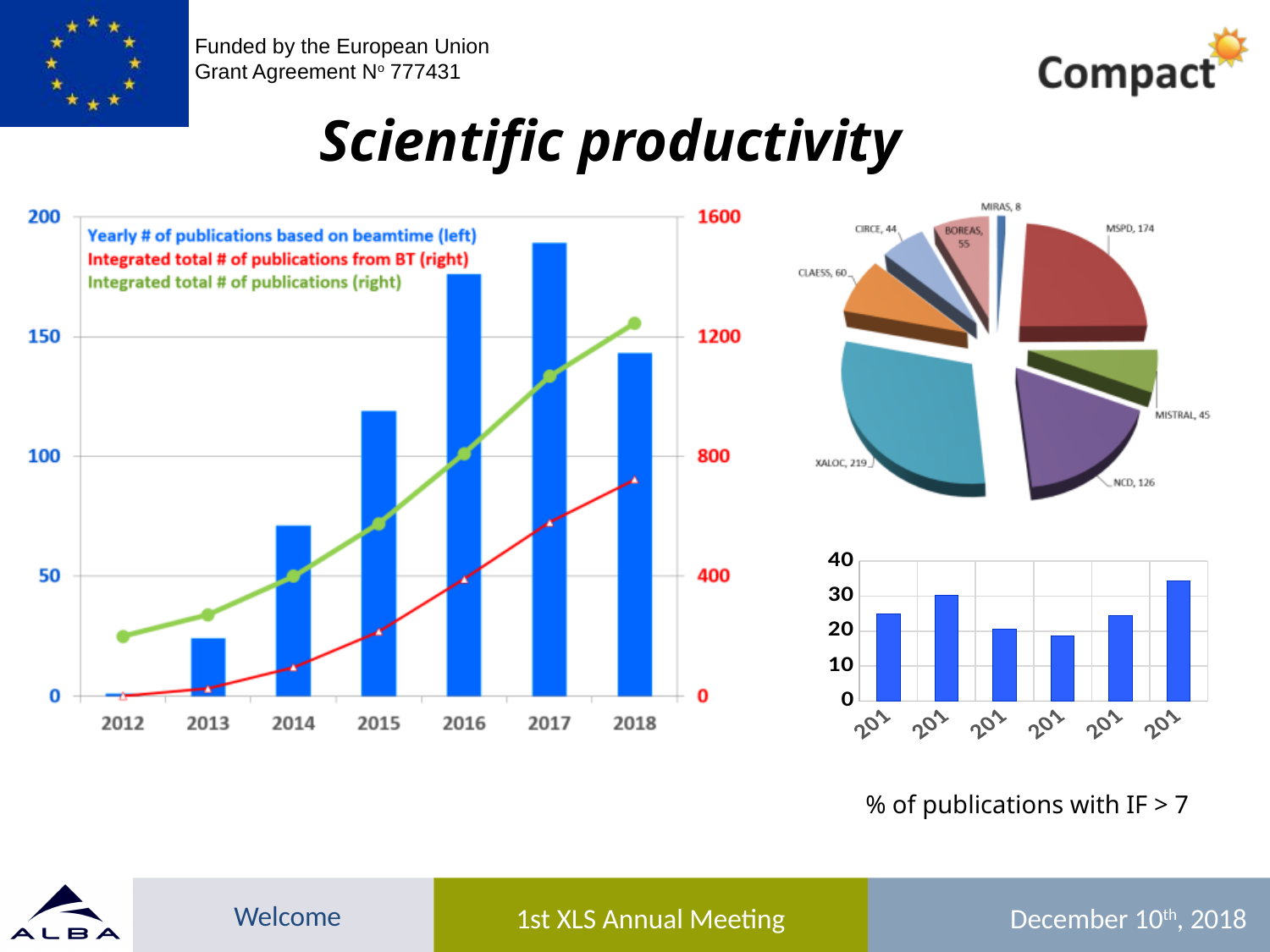
In the left chart, is the bar for 2016 greater or less than 150? greater In the pie chart at the top right, what value is shown for XALOC? 219 In the left chart, does the green line (integrated total # of publications) rise or fall from 2012 to 2018? rise How many slices does the pie chart at the top right have? 8 In the pie chart at the top right, which slice has the smallest value? MIRAS In the pie chart at the top right, what value is shown for MSPD? 174 In the left chart, which year has the tallest bar for yearly number of publications based on beamtime? 2017 In the pie chart at the top right, what is the difference between the values for MSPD and NCD? 48 How many series does the legend of the left chart list? 3 In the pie chart at the top right, which slice has the largest value? XALOC In the pie chart at the top right, which is larger, CLAESS or BOREAS? CLAESS In the left chart, is the bar for 2013 greater or less than 50? less